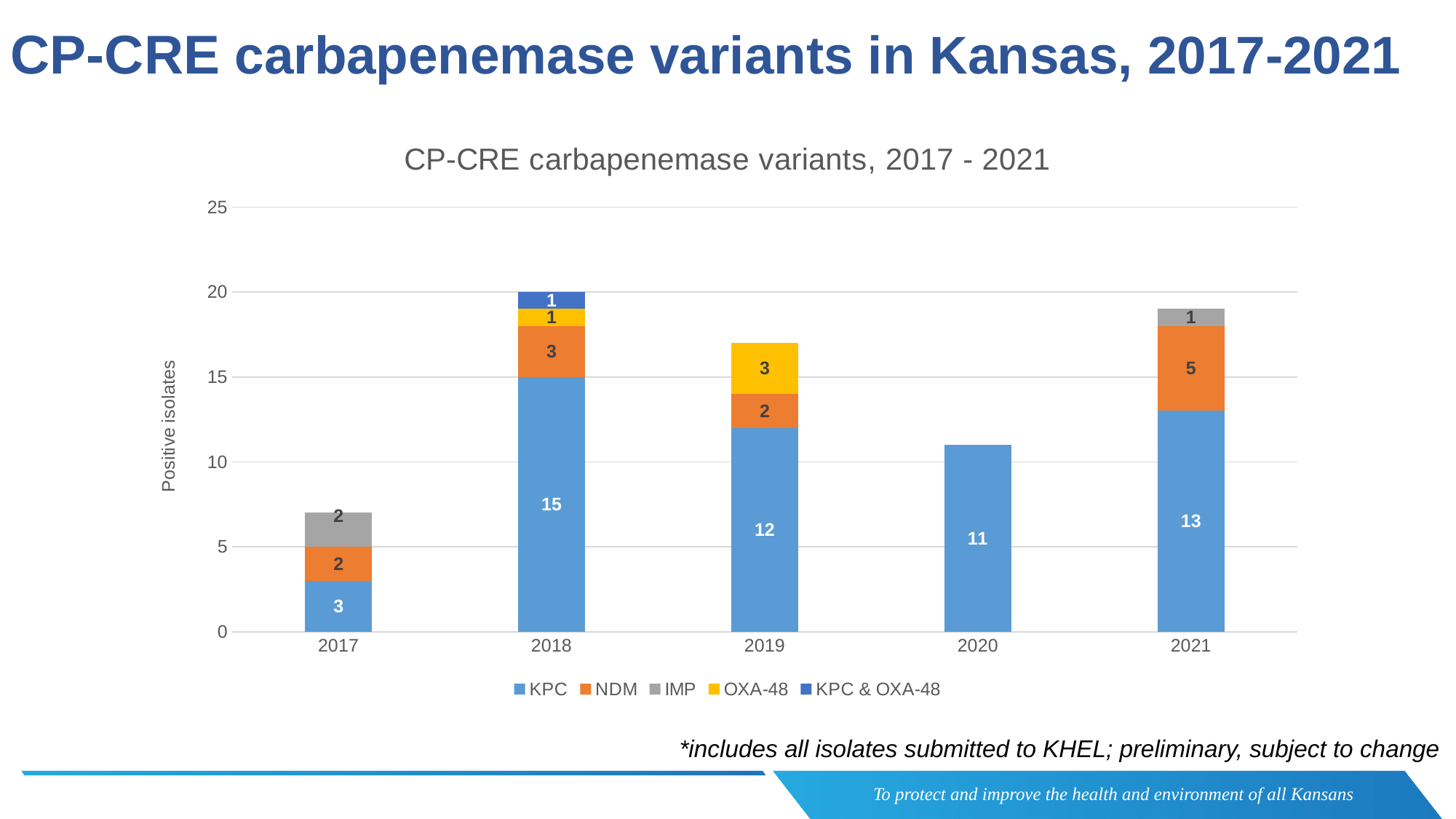
Which is larger, the NDM value for 2018 or the NDM value for 2019? 2018 What is the KPC value for 2018? 15 How many years are shown on the x axis? 5 How many series does the legend list? 5 What is the NDM value for 2021? 5 What is the OXA-48 value for 2019? 3 Which year has the highest KPC value? 2018 What is the IMP value for 2017? 2 Which year has the lowest KPC value? 2017 What is the difference between the KPC values for 2021 and 2020? 2 What is the total of the stacked bar for 2017? 7 What is the total of the stacked bar for 2018? 20